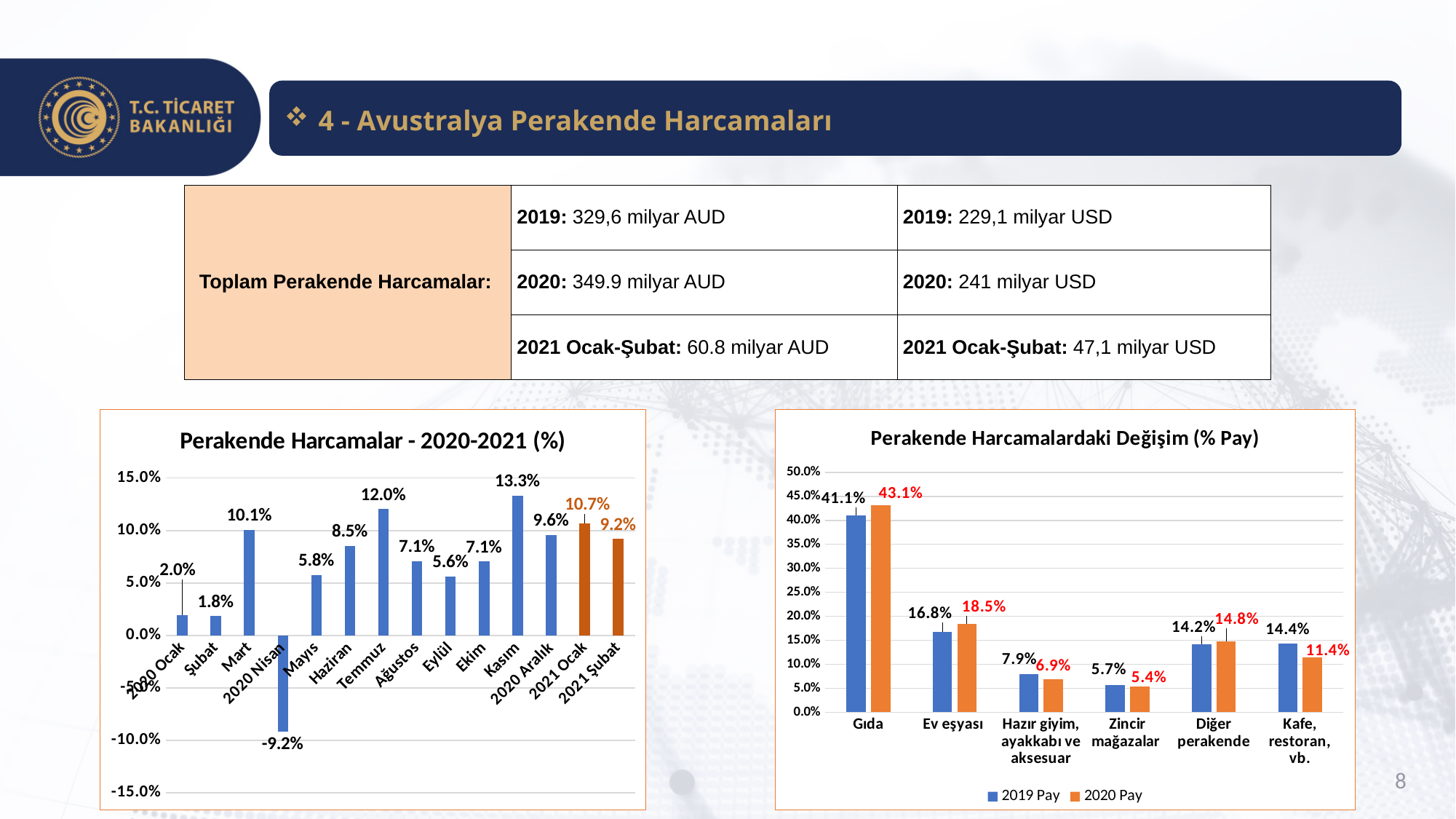
In the chart 'Perakende Harcamalardaki Değişim (% Pay)', which category has the lowest 2020 Pay value? Zincir mağazalar In the chart 'Perakende Harcamalar - 2020-2021 (%)', what is the difference between the values for 2021 Ocak and 2021 Şubat? 1.5% In the chart 'Perakende Harcamalardaki Değişim (% Pay)', what is the 2019 Pay value for Kafe, restoran, vb.? 14.4% In the chart 'Perakende Harcamalardaki Değişim (% Pay)', what is the 2020 Pay value for Gıda? 43.1% In the chart 'Perakende Harcamalar - 2020-2021 (%)', which month has the highest value? Kasım In the chart 'Perakende Harcamalar - 2020-2021 (%)', which month has the lowest value? 2020 Nisan In the chart 'Perakende Harcamalar - 2020-2021 (%)', which is larger, the value for Mart or the value for Temmuz? Temmuz In the chart 'Perakende Harcamalardaki Değişim (% Pay)', how many series does the legend list? 2 In the chart 'Perakende Harcamalar - 2020-2021 (%)', what is the value for Kasım? 13.3% In the chart 'Perakende Harcamalardaki Değişim (% Pay)', what is the difference between the 2019 Pay and 2020 Pay values for Ev eşyası? 1.7% In the chart 'Perakende Harcamalar - 2020-2021 (%)', how many bars are plotted? 14 What kind of chart is 'Perakende Harcamalardaki Değişim (% Pay)'? Bar chart